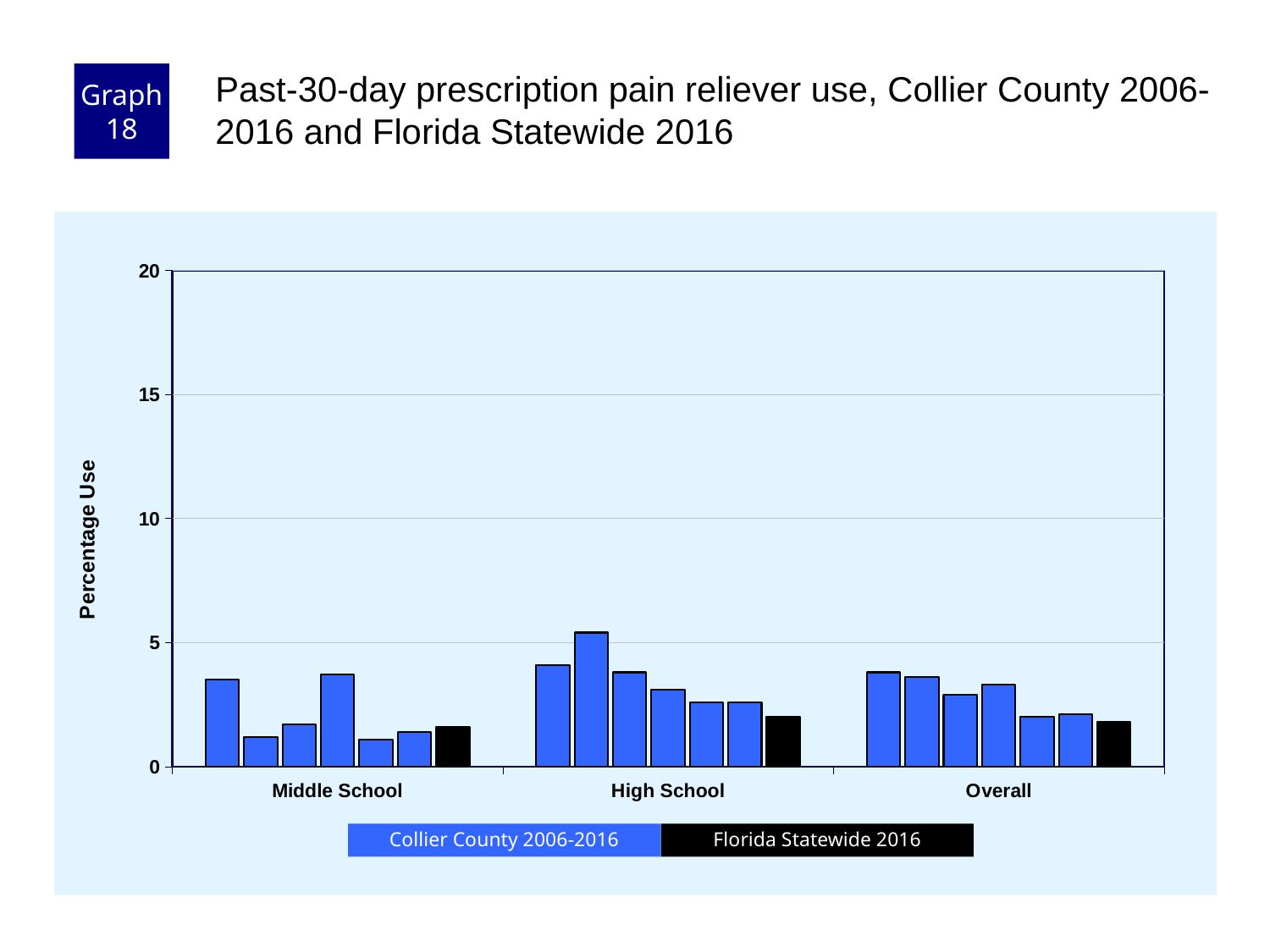
Which category contains the tallest bar in the chart? High School What kind of chart is shown on the slide? bar chart How many series does the legend list? 2 Is the Florida Statewide 2016 value for High School greater or less than 5? less How many categories are shown on the x axis? 3 Is the tallest Collier County 2006-2016 bar for High School greater or less than 10? less Which series is shown in black in the legend? Florida Statewide 2016 What is the highest value shown on the y axis? 20 Is the Florida Statewide 2016 value for Middle School greater or less than 5? less What is the label of the y axis? Percentage Use Is the Florida Statewide 2016 bar larger for Middle School or for High School? High School